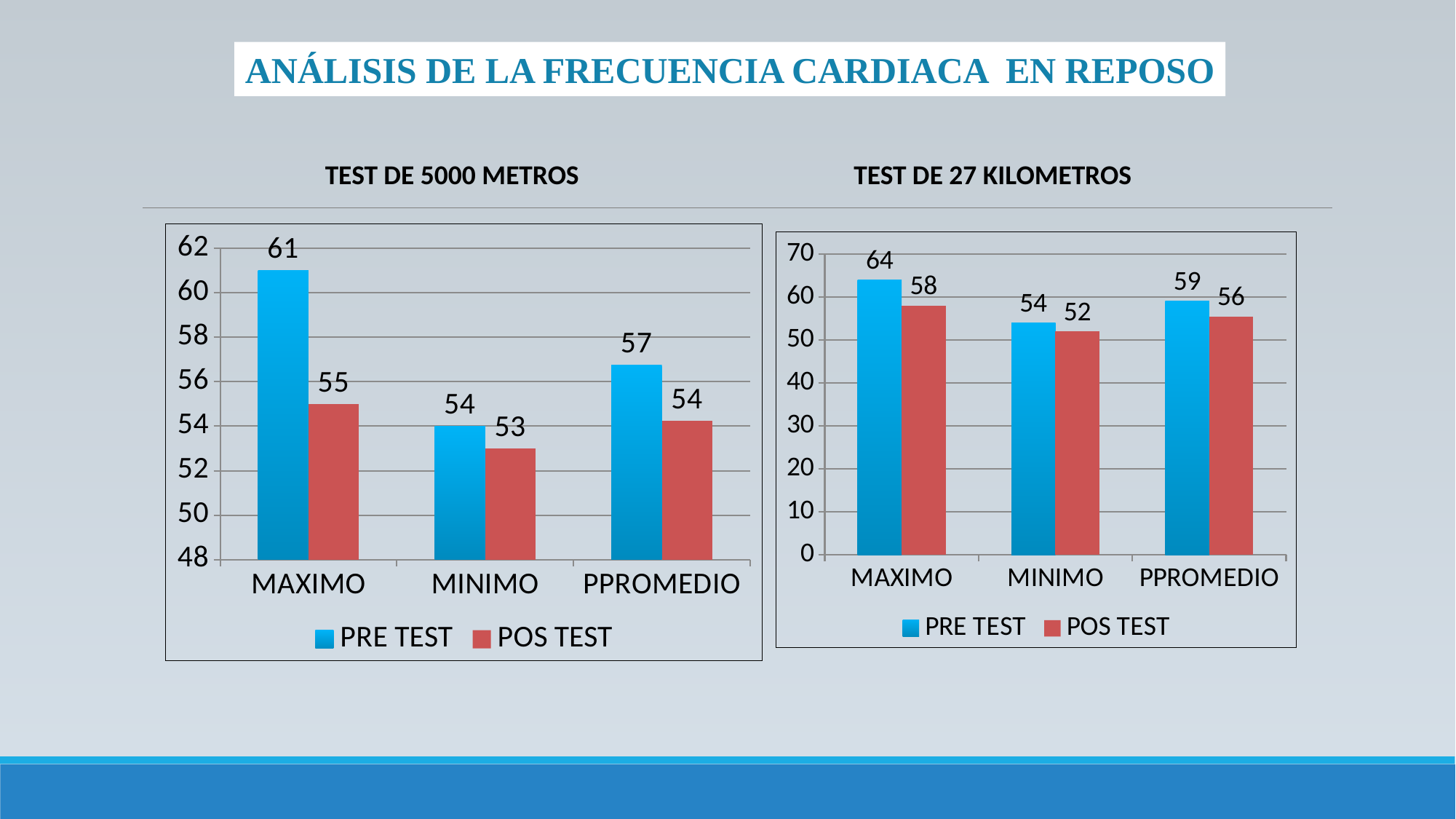
In the TEST DE 5000 METROS chart, what is the PRE TEST value for MAXIMO? 61 In the TEST DE 5000 METROS chart, which category has the highest PRE TEST value? MAXIMO What kind of chart is the TEST DE 5000 METROS chart? Bar chart How many categories are shown on the x axis of the TEST DE 5000 METROS chart? 3 In the TEST DE 27 KILOMETROS chart, what is the difference between the PRE TEST and POS TEST values for PPROMEDIO? 3 In the TEST DE 5000 METROS chart, what is the POS TEST value for MINIMO? 53 In the TEST DE 27 KILOMETROS chart, what is the POS TEST value for MAXIMO? 58 In the TEST DE 27 KILOMETROS chart, what is the PRE TEST value for PPROMEDIO? 59 In the TEST DE 5000 METROS chart, what is the difference between the PRE TEST and POS TEST values for MAXIMO? 6 In the TEST DE 27 KILOMETROS chart, which is larger for MINIMO: the PRE TEST value or the POS TEST value? PRE TEST In the TEST DE 27 KILOMETROS chart, which category has the lowest POS TEST value? MINIMO How many series does the legend of the TEST DE 27 KILOMETROS chart list? 2